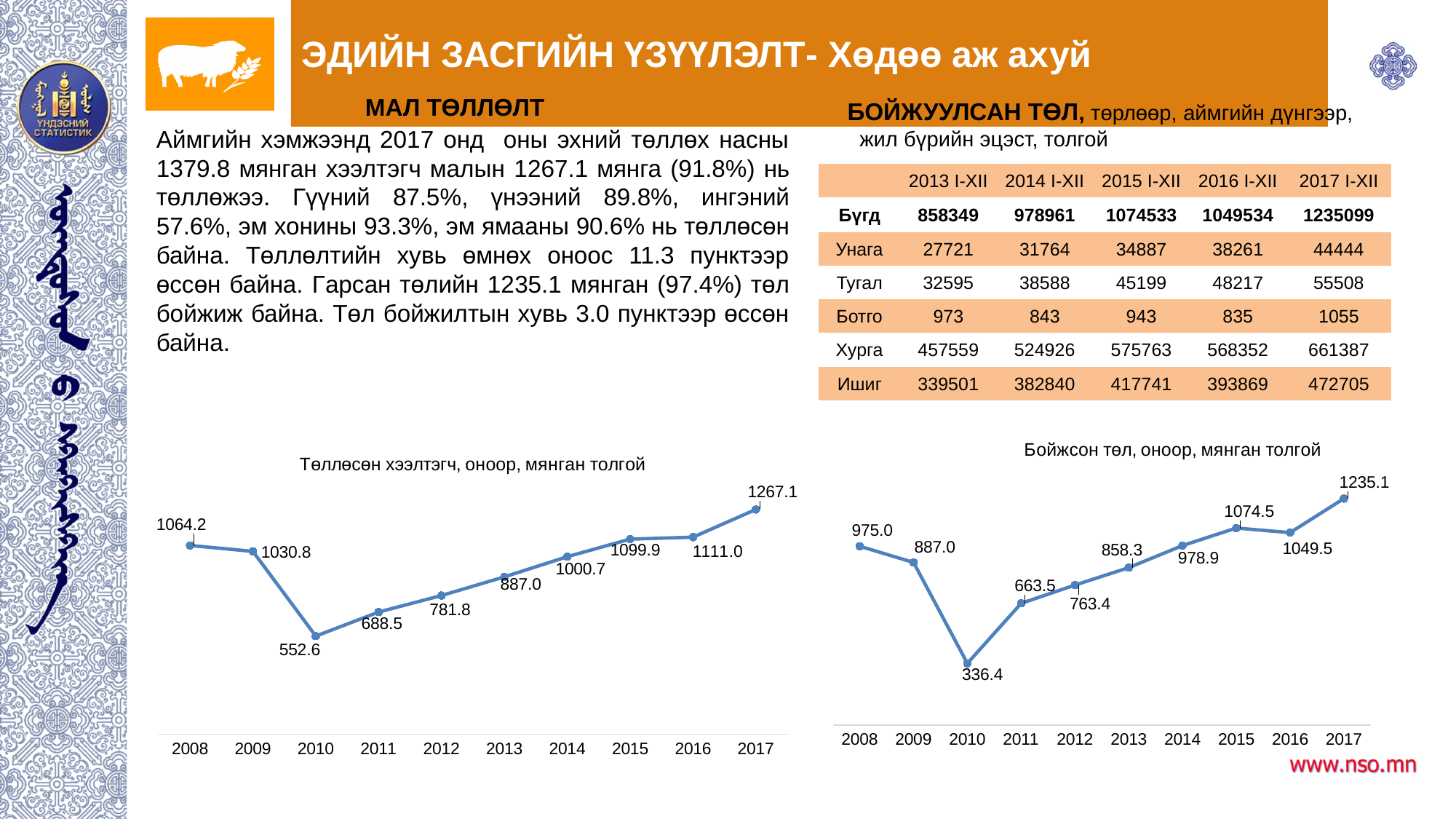
In the chart titled "Бойжсон төл, оноор, мянган толгой", which year has the highest value? 2017 In the chart titled "Бойжсон төл, оноор, мянган толгой", what is the value for 2015? 1074.5 In the chart titled "Төллөсөн хээлтэгч, оноор, мянган толгой", which year has the highest value? 2017 In the chart titled "Төллөсөн хээлтэгч, оноор, мянган толгой", what is the value for 2017? 1267.1 In the chart titled "Төллөсөн хээлтэгч, оноор, мянган толгой", what is the difference between the 2017 value and the 2016 value? 156.1 In the chart titled "Бойжсон төл, оноор, мянган толгой", what is the difference between the 2008 value and the 2009 value? 88.0 In the chart titled "Төллөсөн хээлтэгч, оноор, мянган толгой", what is the value for 2010? 552.6 In the chart titled "Бойжсон төл, оноор, мянган толгой", which is larger, the value for 2015 or the value for 2016? 2015 What kind of chart is the chart titled "Бойжсон төл, оноор, мянган толгой"? line chart In the chart titled "Төллөсөн хээлтэгч, оноор, мянган толгой", how many years are plotted? 10 In the chart titled "Бойжсон төл, оноор, мянган толгой", what is the value for 2010? 336.4 In the chart titled "Төллөсөн хээлтэгч, оноор, мянган толгой", which year has the lowest value? 2010